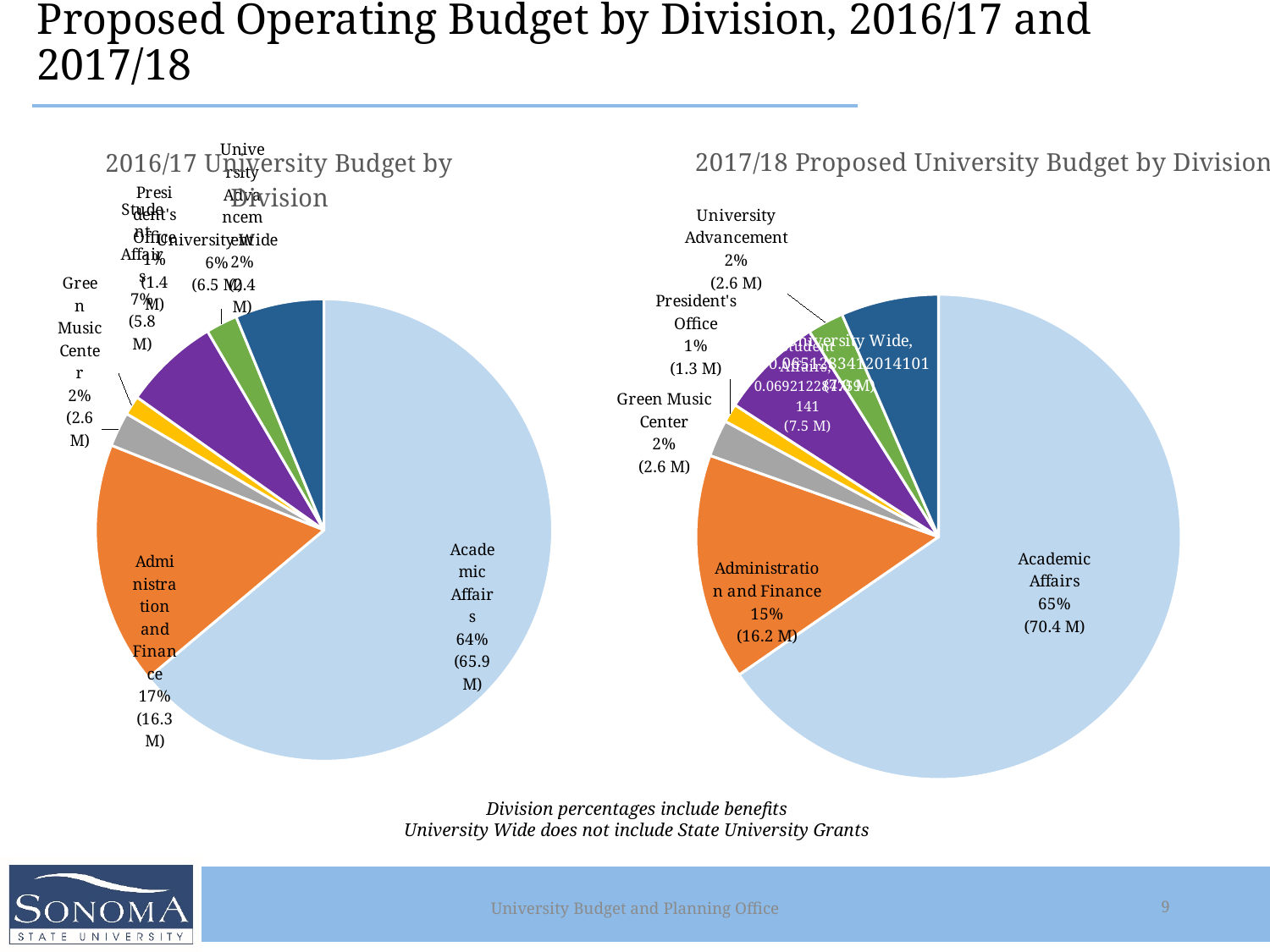
What kind of chart is the 2017/18 Proposed University Budget by Division chart? Pie chart Which is larger: the Administration and Finance share in the 2016/17 chart or in the 2017/18 chart? 2016/17 (17%) In the 2017/18 Proposed University Budget by Division chart, what is the dollar amount shown for Administration and Finance? 16.2 M How many slices does the 2017/18 Proposed University Budget by Division pie chart have? 7 In the 2017/18 Proposed University Budget by Division chart, what is the dollar amount shown for Green Music Center? 2.6 M In the 2017/18 Proposed University Budget by Division chart, which division has the largest share of the budget? Academic Affairs In the 2017/18 Proposed University Budget by Division chart, what percentage of the budget goes to the President's Office? 1% How much larger is the Academic Affairs amount in the 2017/18 chart (70.4 M) than in the 2016/17 chart (65.9 M)? 4.5 M In the 2017/18 Proposed University Budget by Division chart, what percentage of the budget goes to Academic Affairs? 65% In the 2016/17 University Budget by Division chart, what percentage of the budget goes to Administration and Finance? 17% In the 2016/17 University Budget by Division chart, what is the dollar amount shown for Academic Affairs? 65.9 M In the 2017/18 Proposed University Budget by Division chart, which division has the smallest share of the budget? President's Office